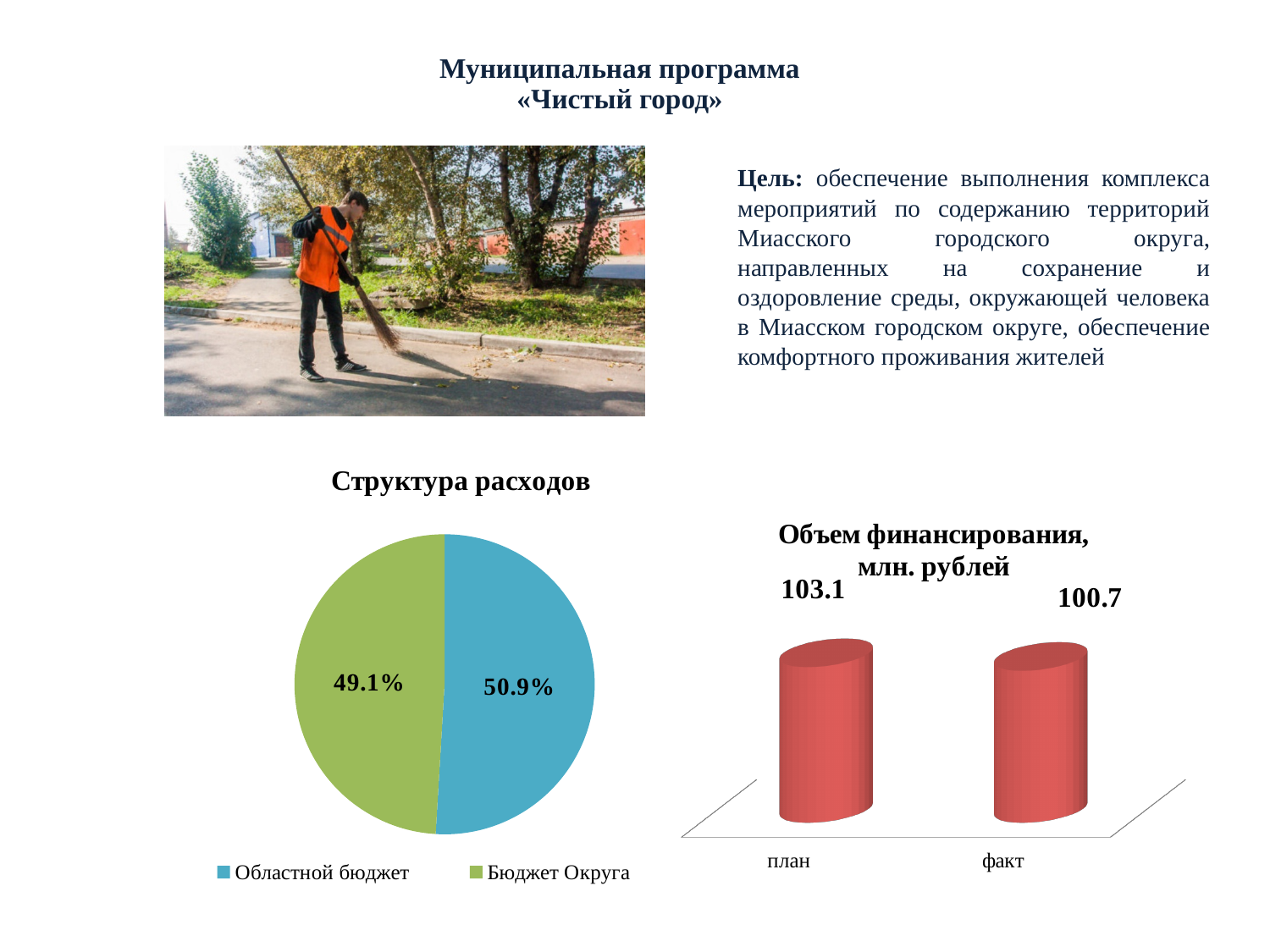
In the 'Объем финансирования, млн. рублей' chart, what is the value for 'факт'? 100.7 How many slices does the 'Структура расходов' pie chart have? 2 In the 'Структура расходов' pie chart, which colour represents 'Бюджет Округа'? Green In the 'Структура расходов' pie chart, what share does 'Бюджет Округа' have? 49.1% In the 'Объем финансирования, млн. рублей' chart, which category has the higher value? план What type of chart is 'Структура расходов'? Pie chart In the 'Структура расходов' pie chart, what is the difference between the 'Областной бюджет' and 'Бюджет Округа' shares? 1.8% In the 'Объем финансирования, млн. рублей' chart, what is the value for 'план'? 103.1 In the 'Объем финансирования, млн. рублей' chart, what is the difference between 'план' and 'факт'? 2.4 What type of chart is 'Объем финансирования, млн. рублей'? Bar chart In the 'Структура расходов' pie chart, which slice is larger: 'Областной бюджет' or 'Бюджет Округа'? Областной бюджет In the 'Структура расходов' pie chart, what share does 'Областной бюджет' have? 50.9%